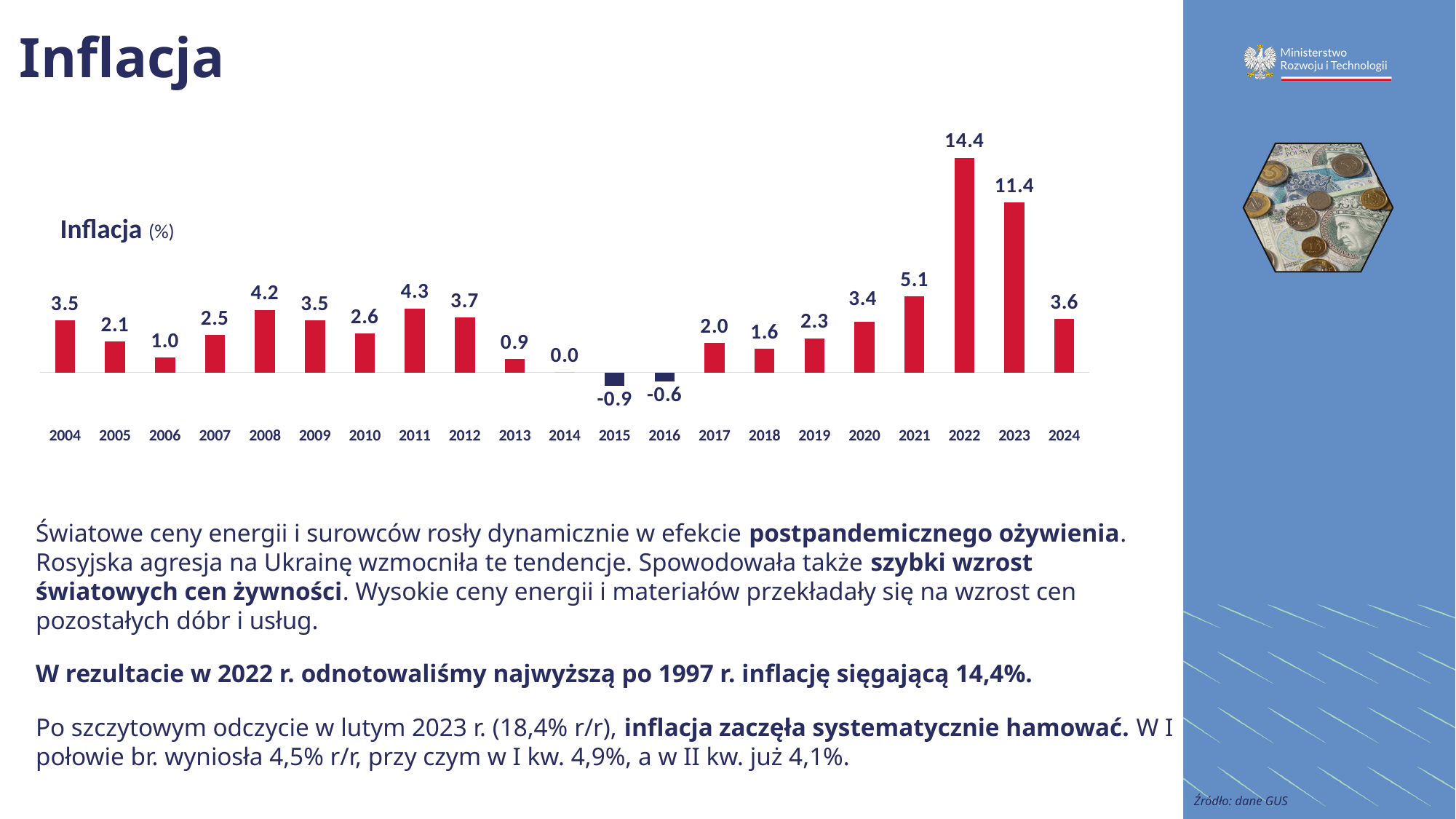
What is the inflation value shown for 2022? 14.4 What is the inflation value shown for 2015? -0.9 Which year has the lowest inflation value on the chart? 2015 Which year has the highest inflation value on the chart? 2022 Do the inflation values rise or fall from 2022 to 2024? fall How many years are shown on the x axis of the chart? 21 What unit is given in the chart title next to 'Inflacja'? % What is the inflation value shown for 2024? 3.6 Which year has a higher inflation value, 2008 or 2011? 2011 How many years on the chart have a negative inflation value? 2 What is the difference between the inflation values for 2022 and 2023? 3.0 What kind of chart is shown on the slide? bar chart